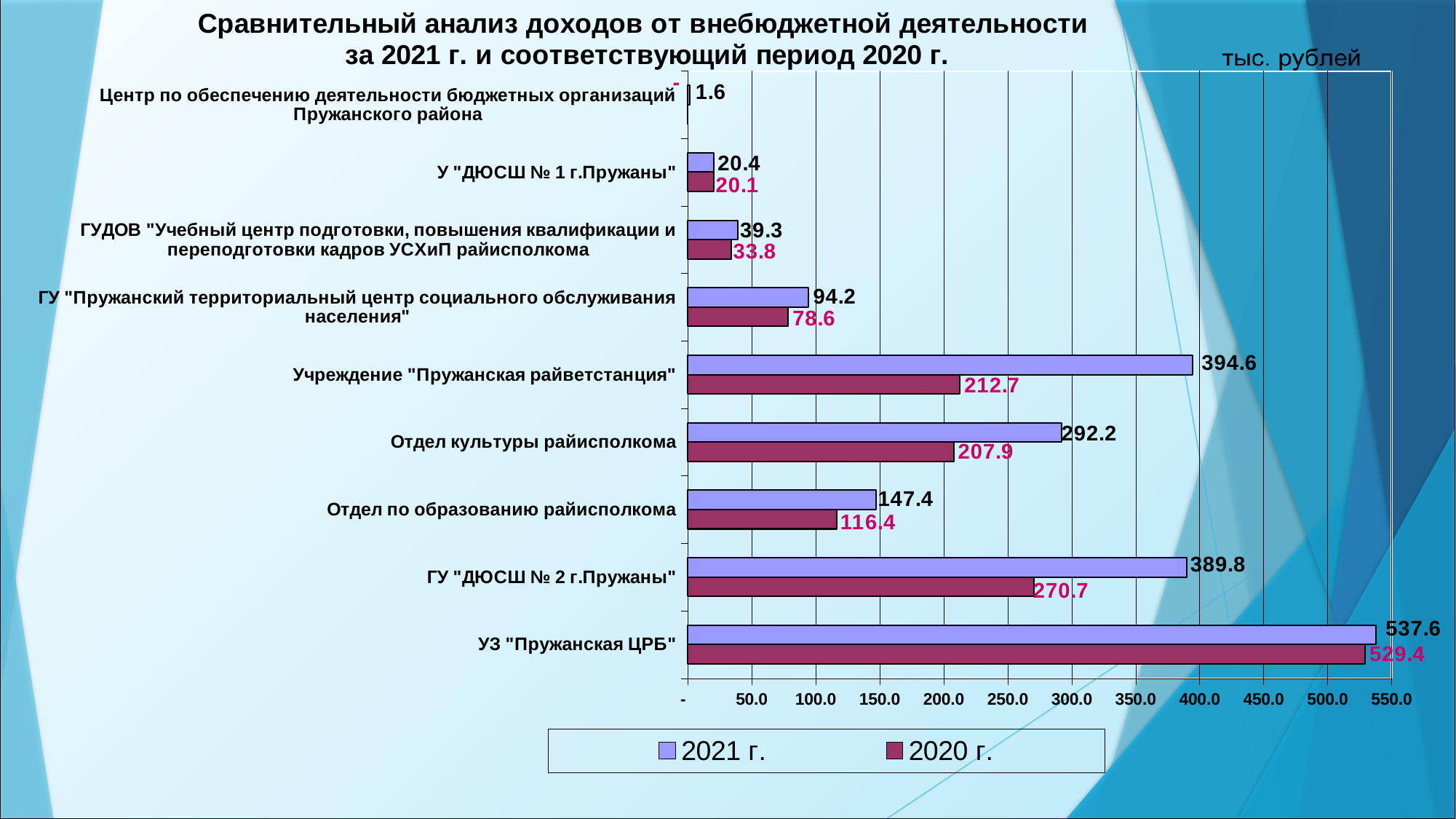
How many series does the legend list? 2 Is the 2020 г. value for Отдел культуры райисполкома greater or less than 250.0? less What unit is indicated in the top right corner of the chart? тыс. рублей What is the 2021 г. value for Отдел по образованию райисполкома? 147.4 What is the 2020 г. value for Учреждение "Пружанская райветстанция"? 212.7 What is the 2021 г. value for УЗ "Пружанская ЦРБ"? 537.6 Which organisation has the lowest 2020 г. value among those with a 2020 bar? У "ДЮСШ № 1 г.Пружаны" How many organisations (categories) are shown on the chart? 9 Which is larger for ГУ "ДЮСШ № 2 г.Пружаны": the 2021 г. value or the 2020 г. value? 2021 г. What is the difference between the 2021 г. and 2020 г. values for Учреждение "Пружанская райветстанция"? 181.9 Which organisation has the highest 2021 г. value? УЗ "Пружанская ЦРБ" What type of chart is shown on the slide? Bar chart